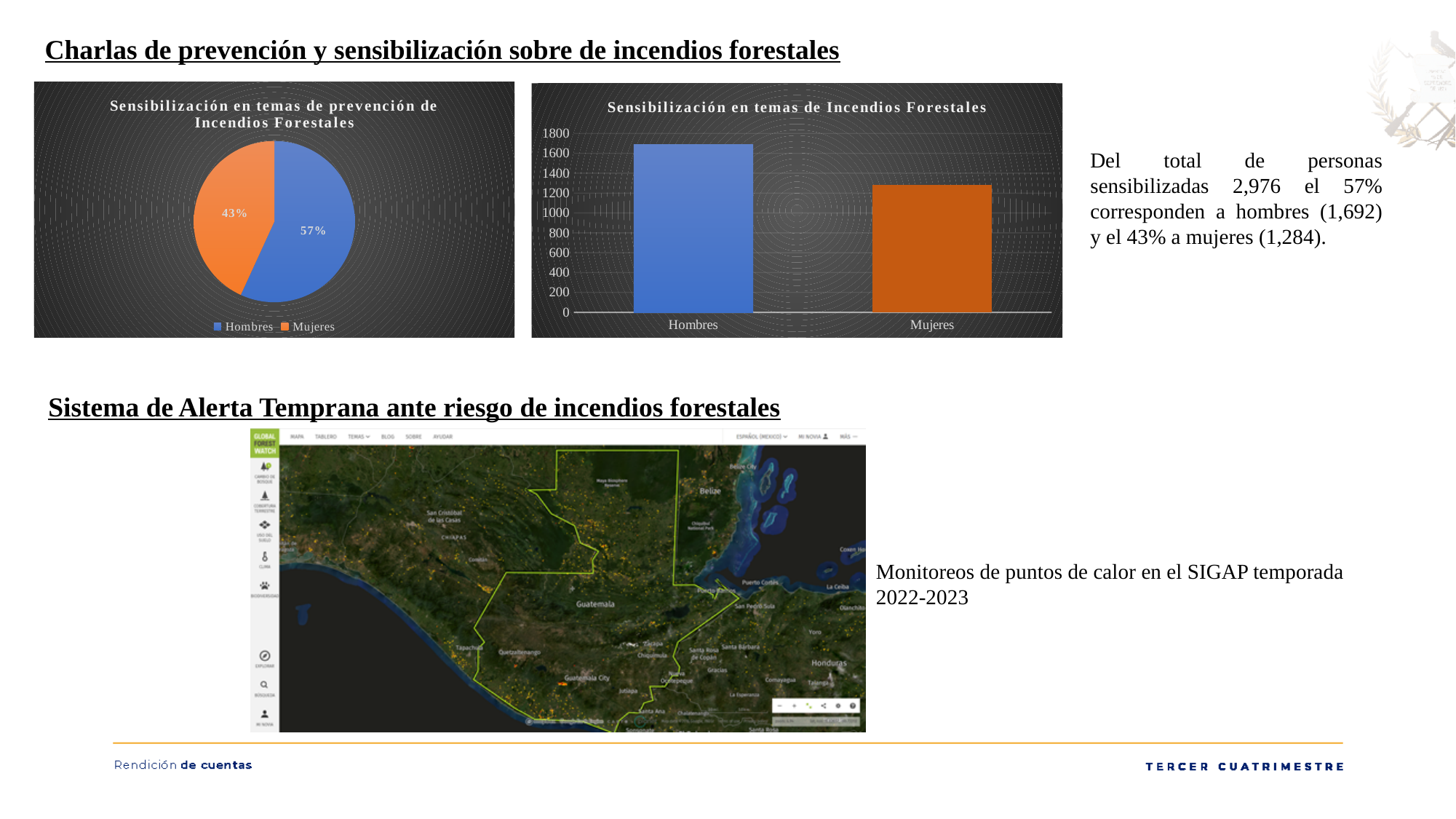
In the pie chart 'Sensibilización en temas de prevención de Incendios Forestales', what share of the pie is Mujeres? 43% In the bar chart 'Sensibilización en temas de Incendios Forestales', which bar is taller, Hombres or Mujeres? Hombres In the bar chart 'Sensibilización en temas de Incendios Forestales', is the value for Hombres greater or less than 1600? greater In the pie chart 'Sensibilización en temas de prevención de Incendios Forestales', what share of the pie is Hombres? 57% In the bar chart 'Sensibilización en temas de Incendios Forestales', is the value for Mujeres greater or less than 1200? greater In the pie chart 'Sensibilización en temas de prevención de Incendios Forestales', what is the difference in percentage points between Hombres and Mujeres? 14% How many categories are shown on the x axis of the bar chart 'Sensibilización en temas de Incendios Forestales'? 2 What kind of chart is the chart on the left titled 'Sensibilización en temas de prevención de Incendios Forestales'? Pie chart In the pie chart 'Sensibilización en temas de prevención de Incendios Forestales', which slice is the largest? Hombres How many entries does the legend of the pie chart 'Sensibilización en temas de prevención de Incendios Forestales' list? 2 In the bar chart 'Sensibilización en temas de Incendios Forestales', is the value for Mujeres greater or less than 1400? less What kind of chart is the chart titled 'Sensibilización en temas de Incendios Forestales'? Bar chart